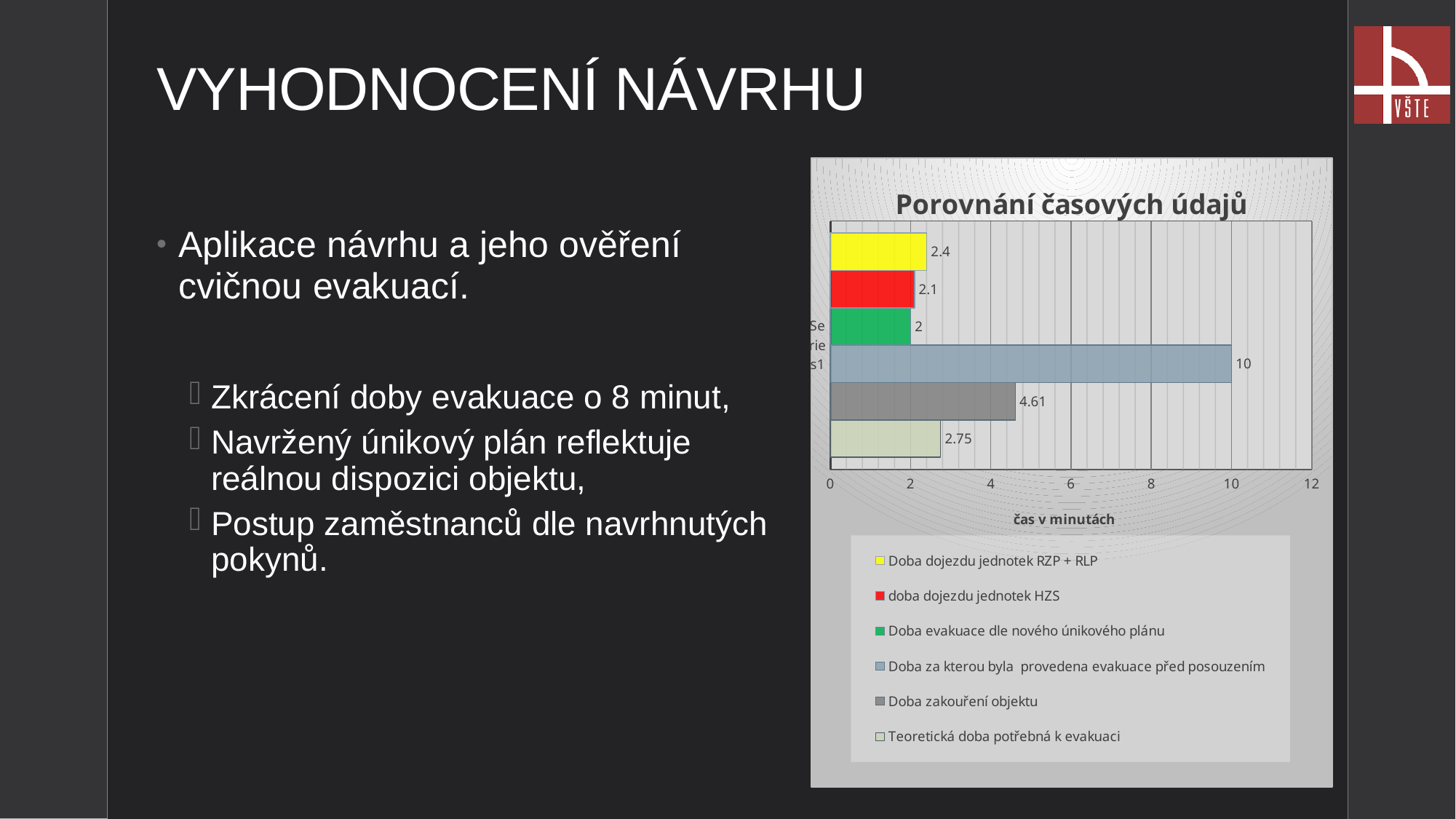
What is the title of the chart? Porovnání časových údajů Which series has the highest value? Doba za kterou byla provedena evakuace před posouzením What is the value for 'Doba dojezdu jednotek RZP + RLP'? 2.4 What is the difference between 'Doba za kterou byla provedena evakuace před posouzením' and 'Doba evakuace dle nového únikového plánu'? 8 What is the value for 'doba dojezdu jednotek HZS'? 2.1 How many series does the chart legend list? 6 What is the value for 'Doba zakouření objektu'? 4.61 What is the value for 'Teoretická doba potřebná k evakuaci'? 2.75 What is the value for 'Doba evakuace dle nového únikového plánu'? 2 Which series has the lowest value? Doba evakuace dle nového únikového plánu What is the value for 'Doba za kterou byla provedena evakuace před posouzením'? 10 What type of chart is shown on the slide? bar chart